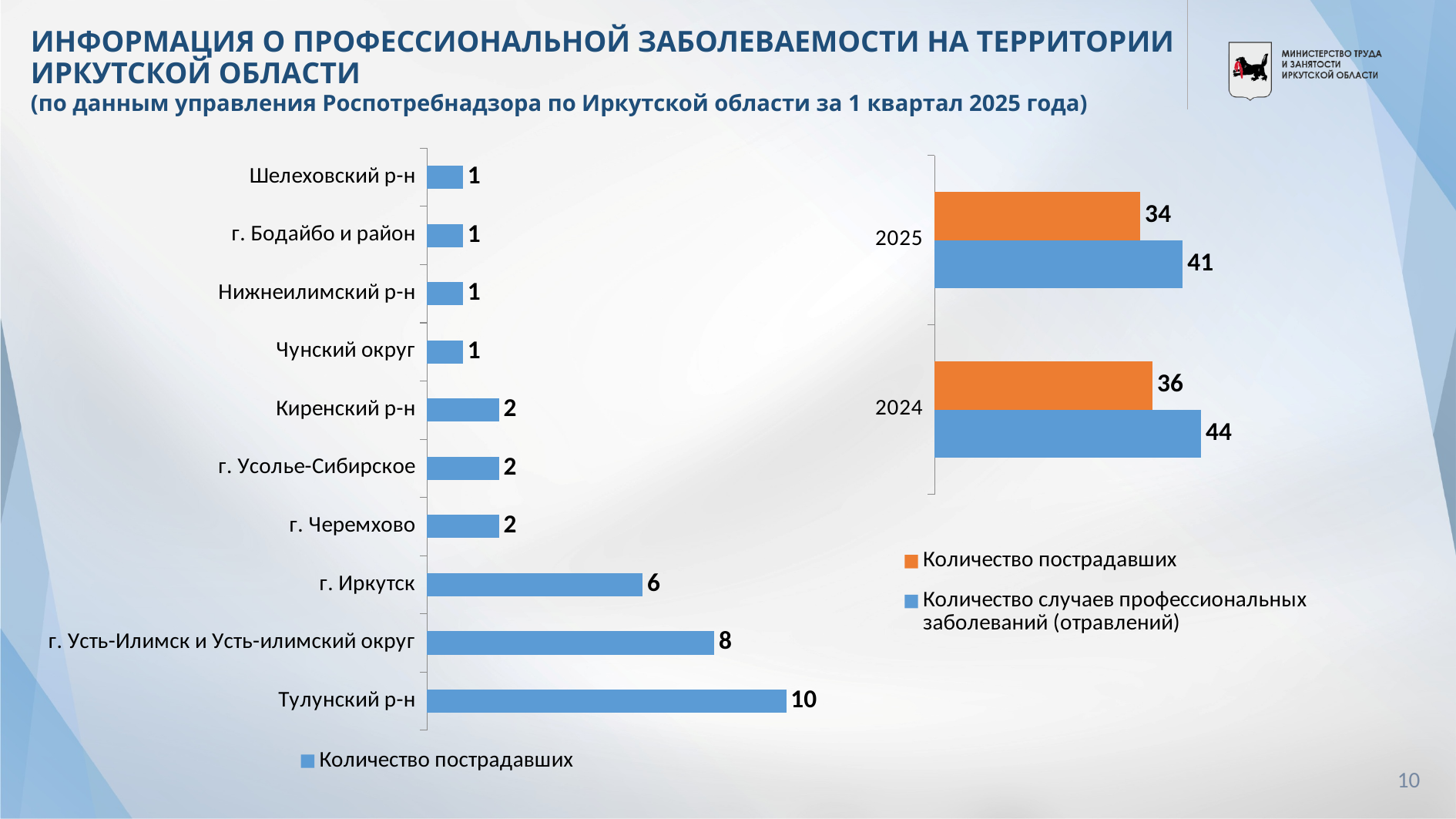
In the left chart, what is the difference between the values for Тулунский р-н and г. Усть-Илимск и Усть-илимский округ? 2 In the left chart, how many categories have a value of 1? 4 In the left chart, which category has the highest value? Тулунский р-н What type of chart is the right chart? Bar chart In the left chart, how many categories are shown? 10 In the right chart, what is the value of Количество случаев профессиональных заболеваний (отравлений) for 2024? 44 In the right chart, what is the difference between Количество случаев профессиональных заболеваний (отравлений) in 2024 and 2025? 3 In the left chart, what is the value for г. Иркутск? 6 In the right chart, what is the value of Количество пострадавших for 2025? 34 In the right chart, how many series does the legend list? 2 In the left chart, which is larger: the value for г. Иркутск or the value for г. Черемхово? г. Иркутск In the left chart, what is the value for Тулунский р-н? 10